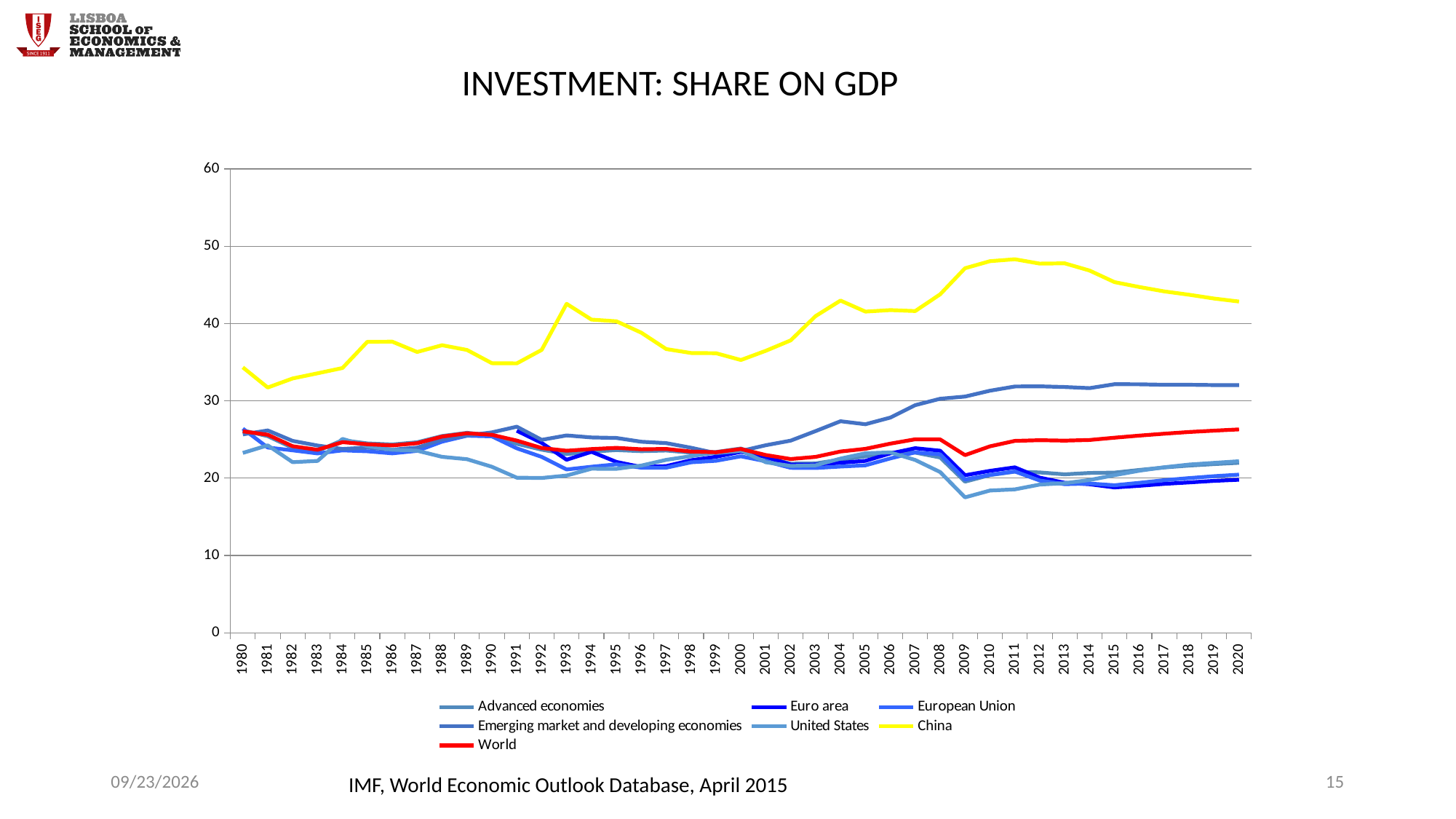
Is the value for China in 2011 greater or less than 40? greater Is the value for Emerging market and developing economies in 2020 greater or less than 30? greater Does the value for China rise or fall from 2011 to 2020? Fall What kind of chart is shown on the slide? Line chart What is the title of the chart? INVESTMENT: SHARE ON GDP Which is larger in 2020, the value for China or the value for World? China How many series does the legend list? 7 Which series has the lowest value in 2009? United States Is the value for United States in 2009 greater or less than 20? less Which series has the highest value in 2020? China How many years are shown along the x axis? 41